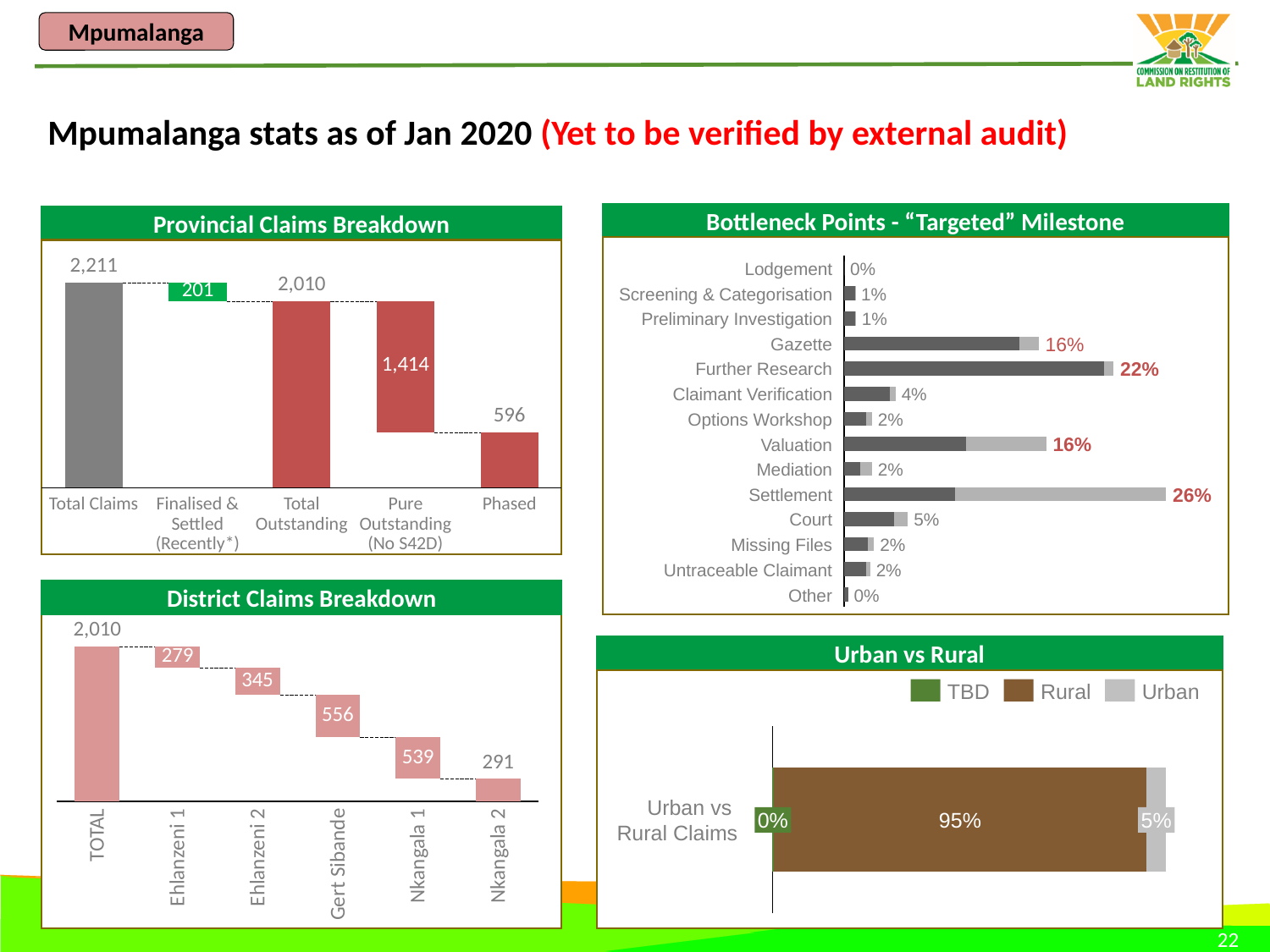
In the Provincial Claims Breakdown chart, what is the difference between Total Outstanding and Phased? 1,414 In the Bottleneck Points chart, which bottleneck point has the highest percentage? Settlement In the Provincial Claims Breakdown chart, what is the value for Pure Outstanding (No S42D)? 1,414 In the Bottleneck Points chart, what is the percentage for Further Research? 22% In the Provincial Claims Breakdown chart, what is the value for Total Claims? 2,211 In the District Claims Breakdown chart, which district has the highest number of claims? Gert Sibande In the District Claims Breakdown chart, what is the value for Nkangala 2? 291 In the Urban vs Rural chart, what percentage of claims are Rural? 95% How many bottleneck points are listed in the Bottleneck Points chart? 14 How many series does the legend of the Urban vs Rural chart list? 3 What kind of chart is the Bottleneck Points chart? Bar chart In the District Claims Breakdown chart, which is larger, Ehlanzeni 1 or Ehlanzeni 2? Ehlanzeni 2